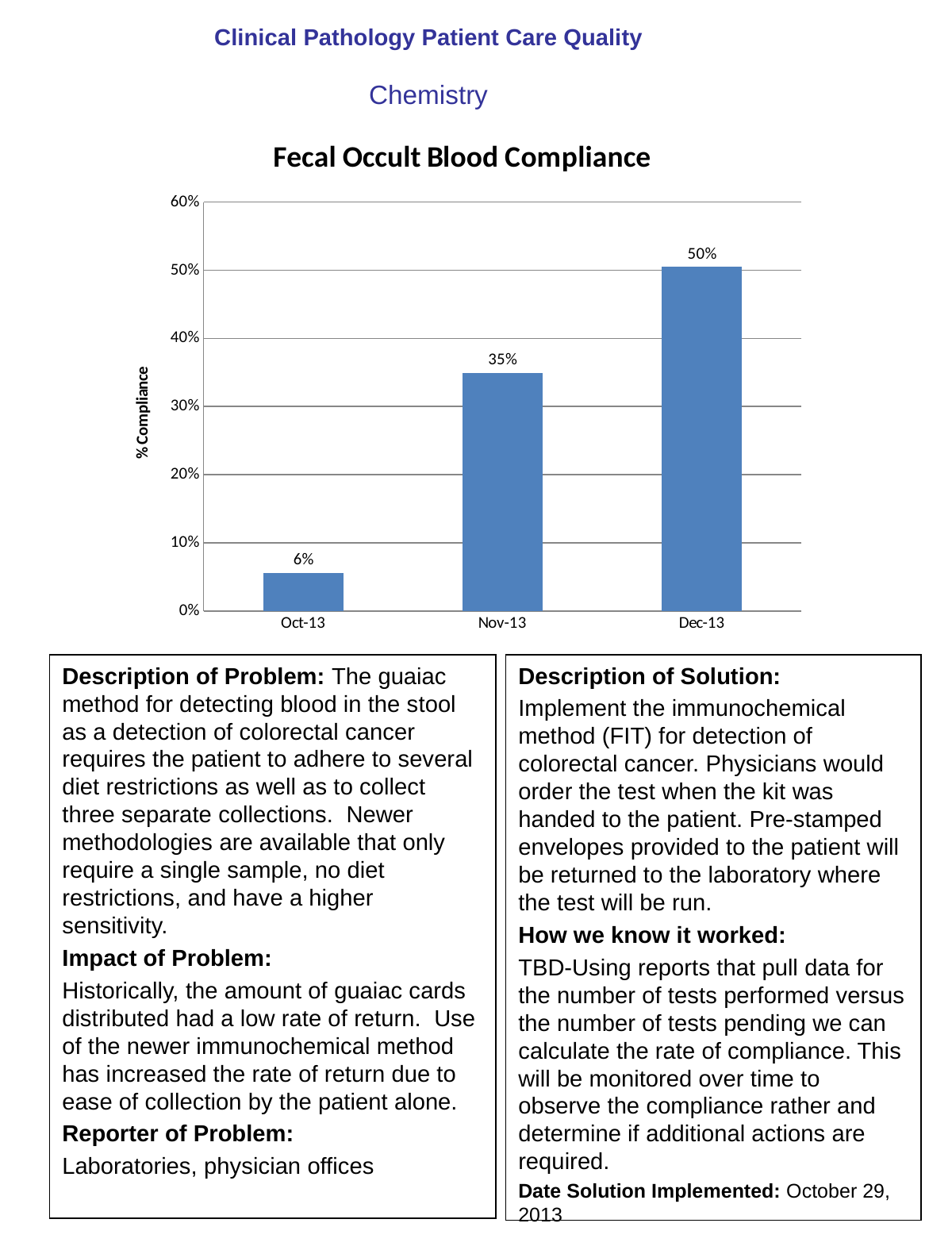
Do the compliance values rise or fall from Oct-13 to Dec-13? Rise What is the compliance value for Dec-13? 50% How many months are shown on the chart? 3 What is the difference in compliance between Nov-13 and Oct-13? 29% What is the compliance value for Nov-13? 35% What is the compliance value for Oct-13? 6% Which month has the highest compliance? Dec-13 Which is larger, the compliance for Nov-13 or for Oct-13? Nov-13 Which month has the lowest compliance? Oct-13 What is the title of the chart? Fecal Occult Blood Compliance What is the difference in compliance between Dec-13 and Nov-13? 15% What kind of chart is shown? Bar chart